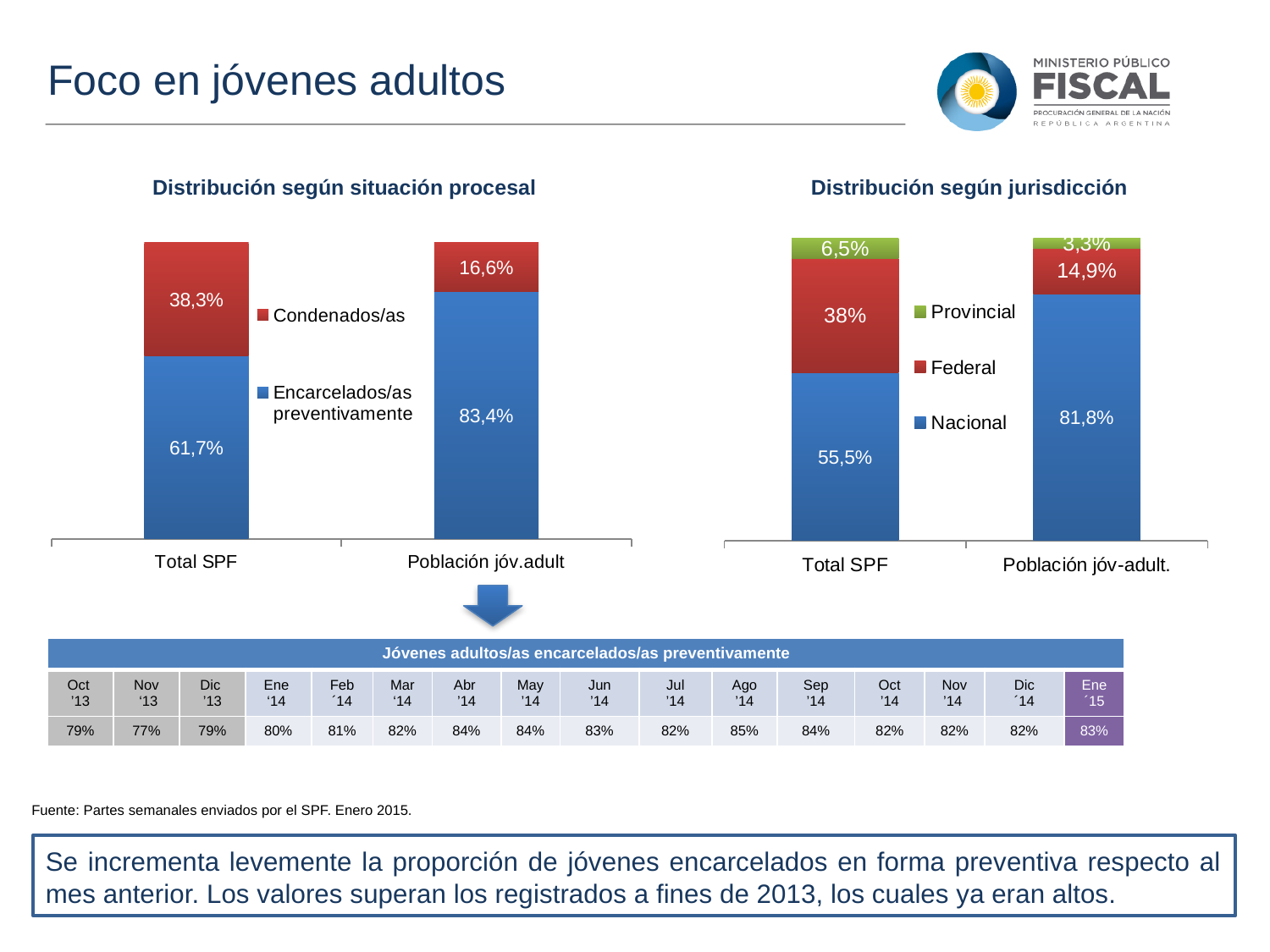
What kind of chart is 'Distribución según jurisdicción'? Stacked bar chart In the 'Distribución según situación procesal' chart, what is the difference between the Encarcelados/as preventivamente values for Población jóv.adult and Total SPF? 21,7 percentage points In the 'Distribución según jurisdicción' chart, what is the Provincial value for Población jóv-adult.? 3,3% In the 'Distribución según situación procesal' chart, what is the value for Condenados/as in the Población jóv.adult bar? 16,6% In the 'Distribución según situación procesal' chart, what is the value for Encarcelados/as preventivamente in the Total SPF bar? 61,7% In the 'Distribución según situación procesal' chart, how many series does the legend list? 2 In the 'Distribución según jurisdicción' chart, how many series does the legend list? 3 In the 'Distribución según jurisdicción' chart, what colour represents the Nacional series? Blue In the 'Distribución según situación procesal' chart, which category has the larger Condenados/as share, Total SPF or Población jóv.adult? Total SPF In the 'Distribución según jurisdicción' chart, which series is the smallest segment in the Población jóv-adult. bar? Provincial In the 'Distribución según jurisdicción' chart, what is the Nacional value for Total SPF? 55,5% In the 'Distribución según jurisdicción' chart, what is the Federal value for Total SPF? 38%